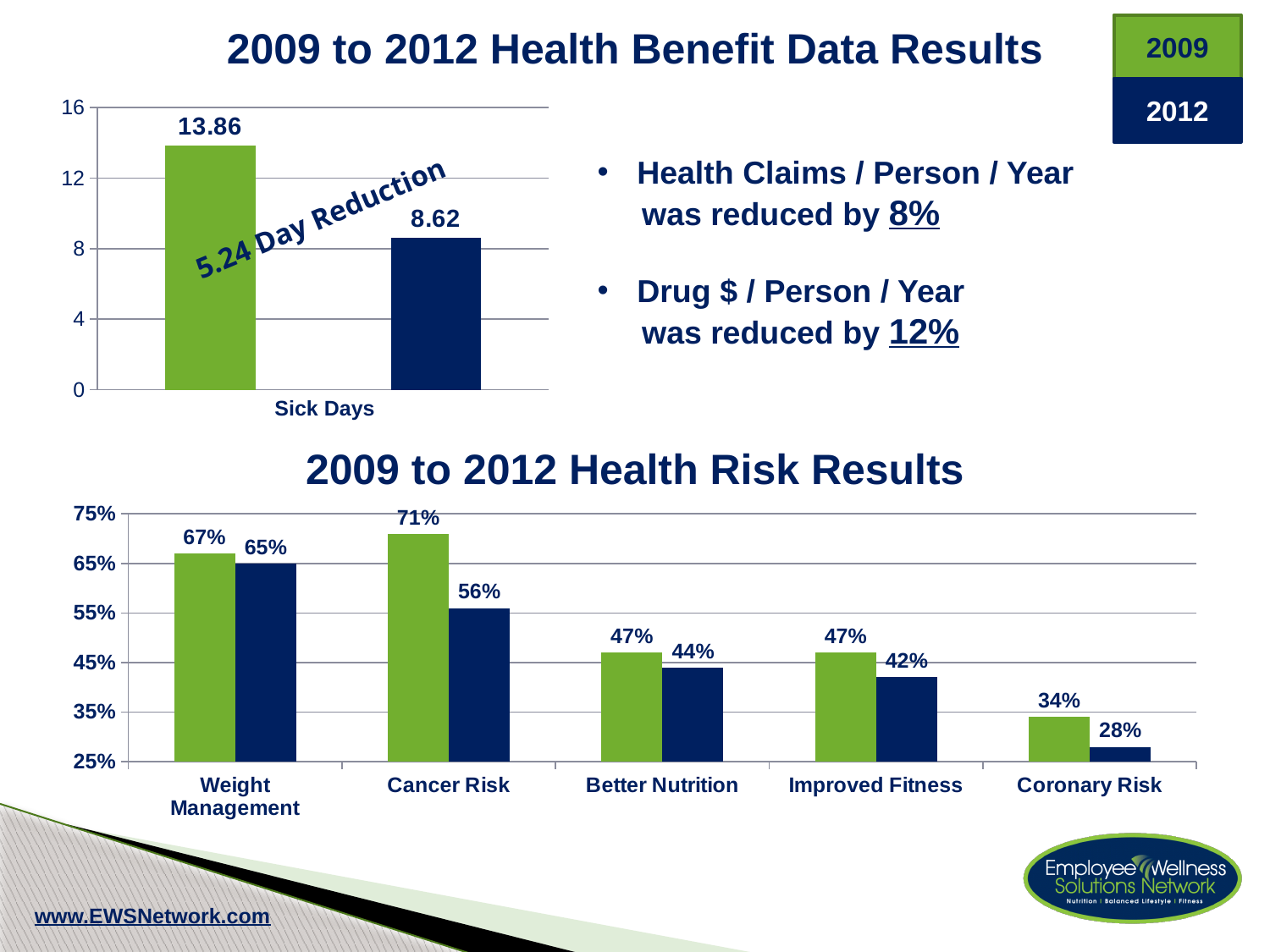
In the 2009 to 2012 Health Risk Results chart, what is the difference between the 2009 and 2012 values for Cancer Risk? 15% In the 2009 to 2012 Health Risk Results chart, which category has the lowest 2012 value? Coronary Risk In the Sick Days chart at the top left, what is the value for 2012? 8.62 In the 2009 to 2012 Health Risk Results chart, how many categories are shown on the x axis? 5 In the 2009 to 2012 Health Risk Results chart, which category has the highest 2009 value? Cancer Risk In the 2009 to 2012 Health Risk Results chart, what is the 2009 value for Cancer Risk? 71% In the Sick Days chart at the top left, which year has the higher value, 2009 or 2012? 2009 In the Sick Days chart at the top left, what is the value for 2009? 13.86 In the 2009 to 2012 Health Risk Results chart, what is the 2012 value for Coronary Risk? 28% What type of chart is the 2009 to 2012 Health Risk Results chart? Bar chart In the 2009 to 2012 Health Risk Results chart, is the 2012 value for Weight Management greater or less than the 2012 value for Better Nutrition? greater In the Sick Days chart at the top left, what is the difference between the 2009 and 2012 values? 5.24